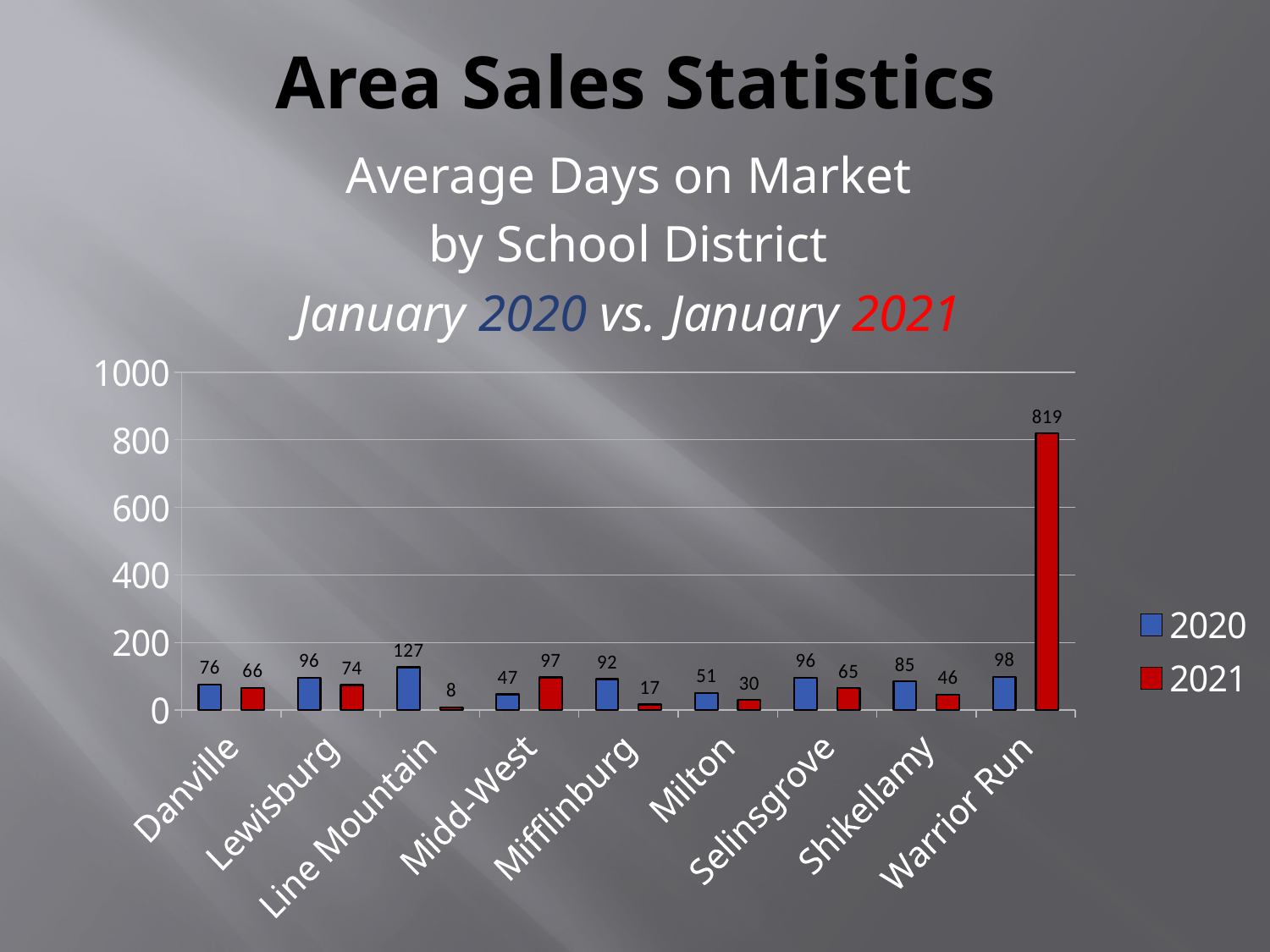
Which school district had the highest average days on market in 2021? Warrior Run Is the 2021 value for Warrior Run greater or less than 800? greater What was the average days on market for Line Mountain in 2020? 127 What was the average days on market for Midd-West in 2021? 97 What was the average days on market for Warrior Run in 2021? 819 What is the difference between the 2020 and 2021 values for Mifflinburg? 75 How many series does the legend list? 2 Which is larger for Midd-West, the 2020 value or the 2021 value? 2021 How many school districts are shown on the x axis? 9 Which school district had the lowest average days on market in 2021? Line Mountain Which school district had the lowest average days on market in 2020? Midd-West What kind of chart is shown on the slide? bar chart